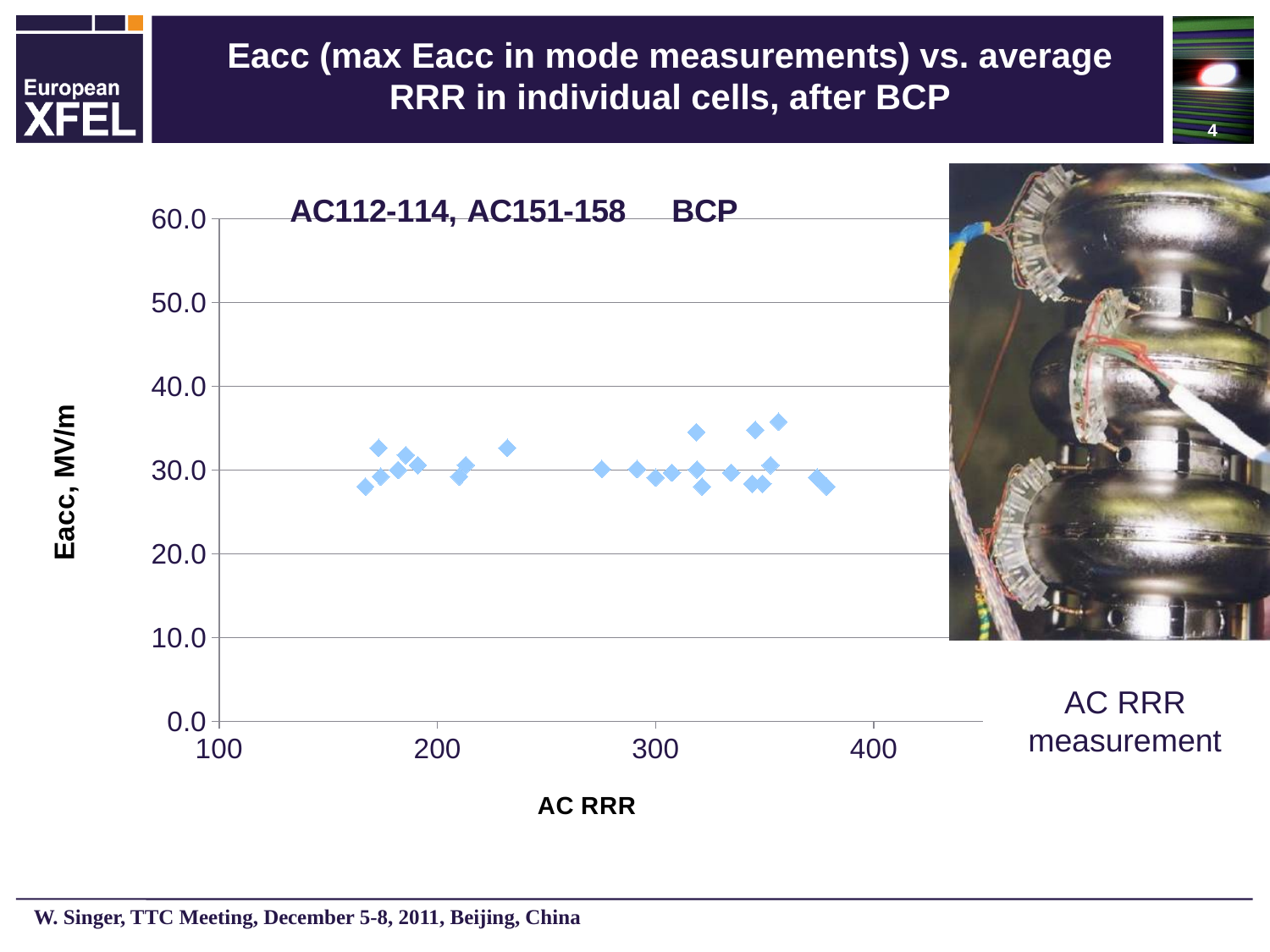
Is the highest Eacc value plotted greater or less than 40.0? less Do the Eacc values show a clear rise or fall as AC RRR increases along the x axis? no clear trend Is the largest AC RRR value plotted greater or less than 400? less What is the label on the vertical axis of the chart? Eacc, MV/m Is the lowest Eacc value plotted greater or less than 20.0? greater What kind of chart is shown on the slide? scatter chart What is the title printed above the chart? AC112-114, AC151-158 BCP